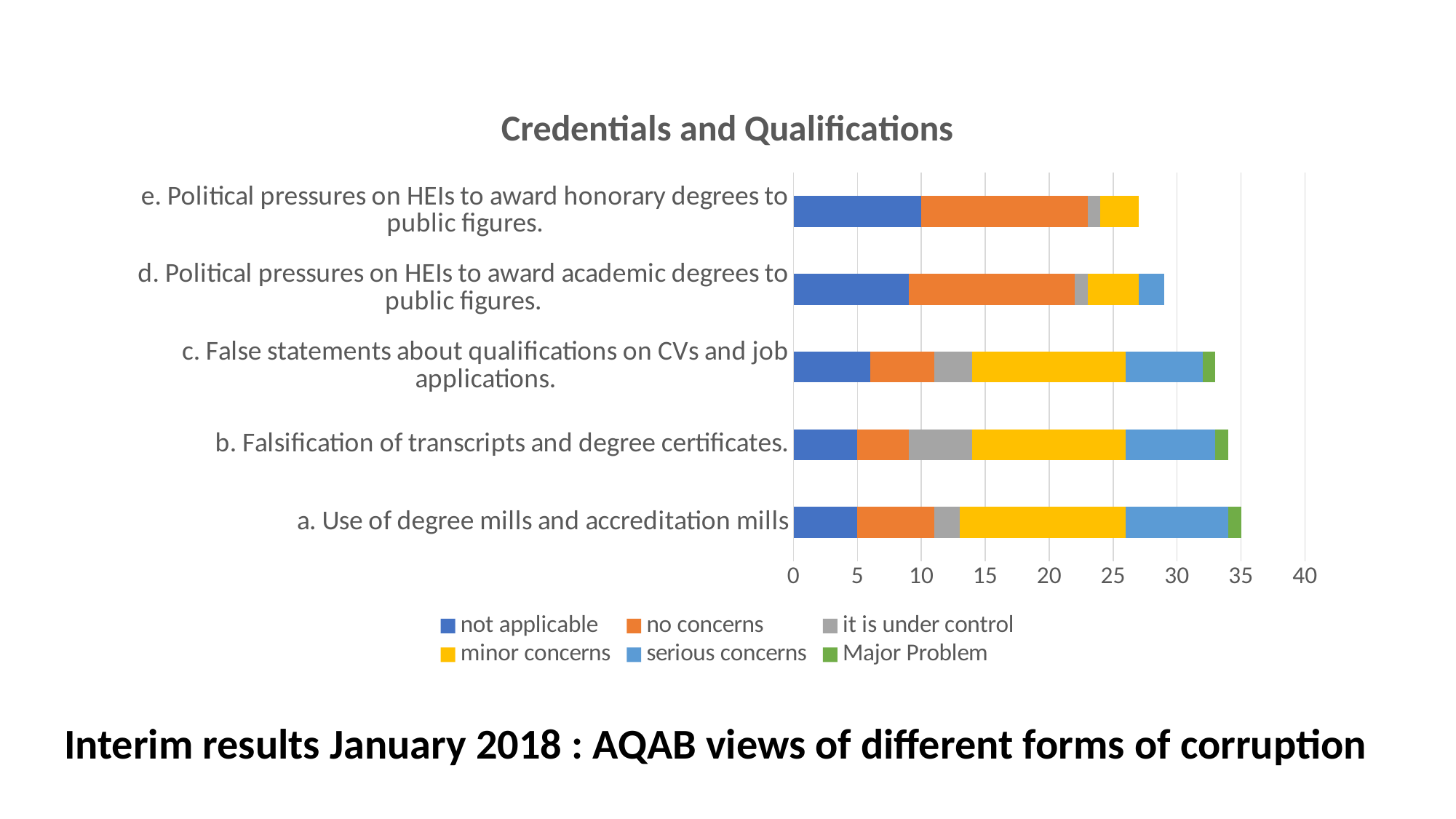
Which series is shown in yellow in the legend? minor concerns How many series does the legend list? 6 Is the total for 'd. Political pressures on HEIs to award academic degrees to public figures.' greater or less than 30? less What is the title of the chart? Credentials and Qualifications What is the 'not applicable' value for 'e. Political pressures on HEIs to award honorary degrees to public figures.'? 10 Is the total bar for 'c. False statements about qualifications on CVs and job applications.' longer or shorter than the total bar for 'e. Political pressures on HEIs to award honorary degrees to public figures.'? longer Is the total for 'e. Political pressures on HEIs to award honorary degrees to public figures.' greater or less than 25? greater Is the total for 'c. False statements about qualifications on CVs and job applications.' greater or less than 30? greater Which category has the shortest total bar? e. Political pressures on HEIs to award honorary degrees to public figures. What kind of chart is shown on the slide? stacked bar chart How many categories are plotted on the chart? 5